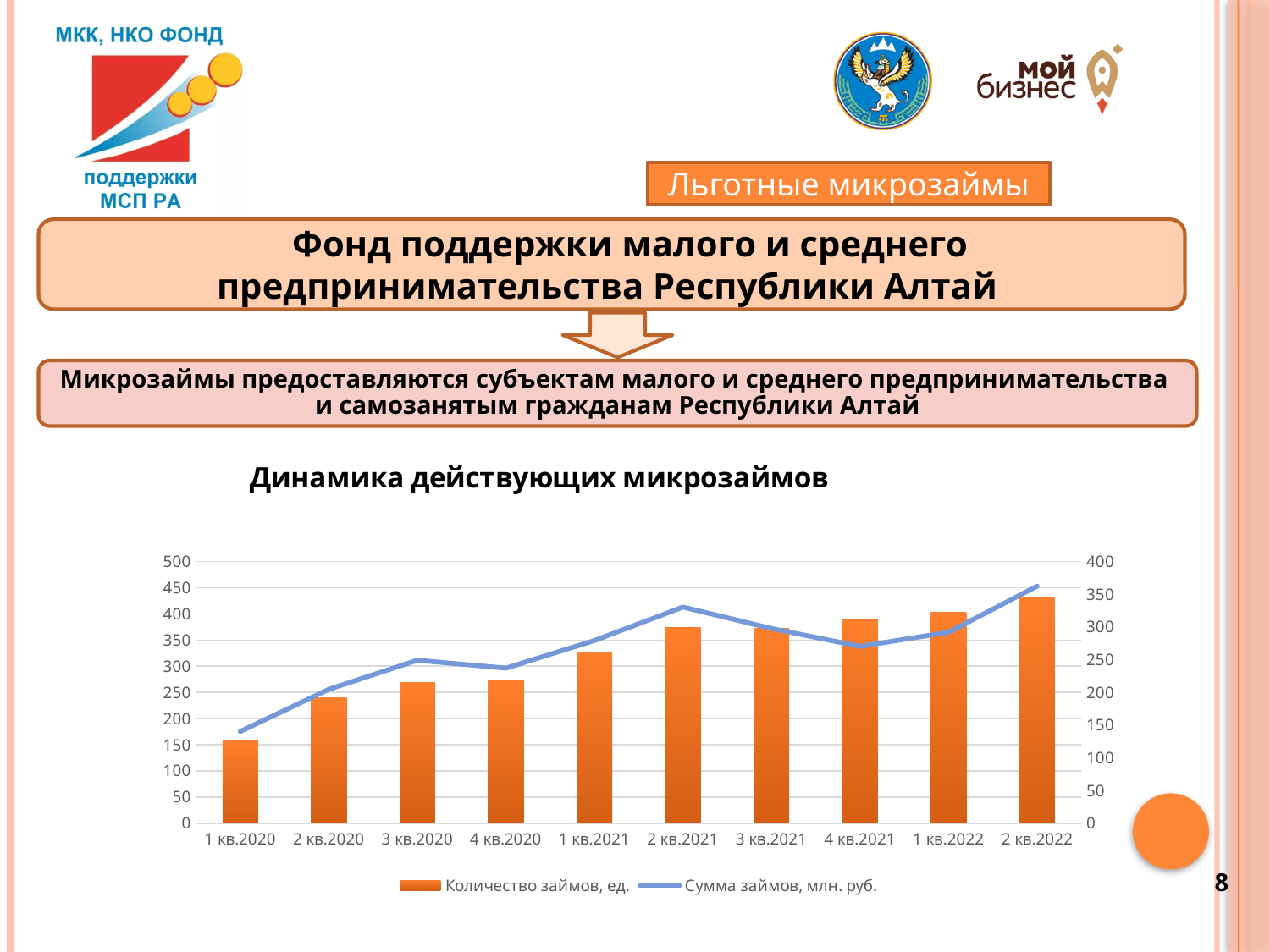
Is the value for Количество займов, ед. in 1 кв.2020 greater or less than 200? less Which quarter has the lowest value for Сумма займов, млн. руб.? 1 кв.2020 Is the value for Количество займов, ед. in 2 кв.2022 greater or less than 400? greater How many quarters are shown on the x axis of the chart? 10 Which is larger for Количество займов, ед.: 2 кв.2020 or 1 кв.2021? 1 кв.2021 How many series does the chart legend list? 2 Do the values for Количество займов, ед. generally rise or fall from 1 кв.2020 to 2 кв.2022? rise Which quarter has the highest value for Количество займов, ед.? 2 кв.2022 What is the title of the chart on the slide? Динамика действующих микрозаймов Which quarter has the highest value for Сумма займов, млн. руб.? 2 кв.2022 Which quarter has the lowest value for Количество займов, ед.? 1 кв.2020 What kind of chart is shown on the slide? Combined bar and line chart